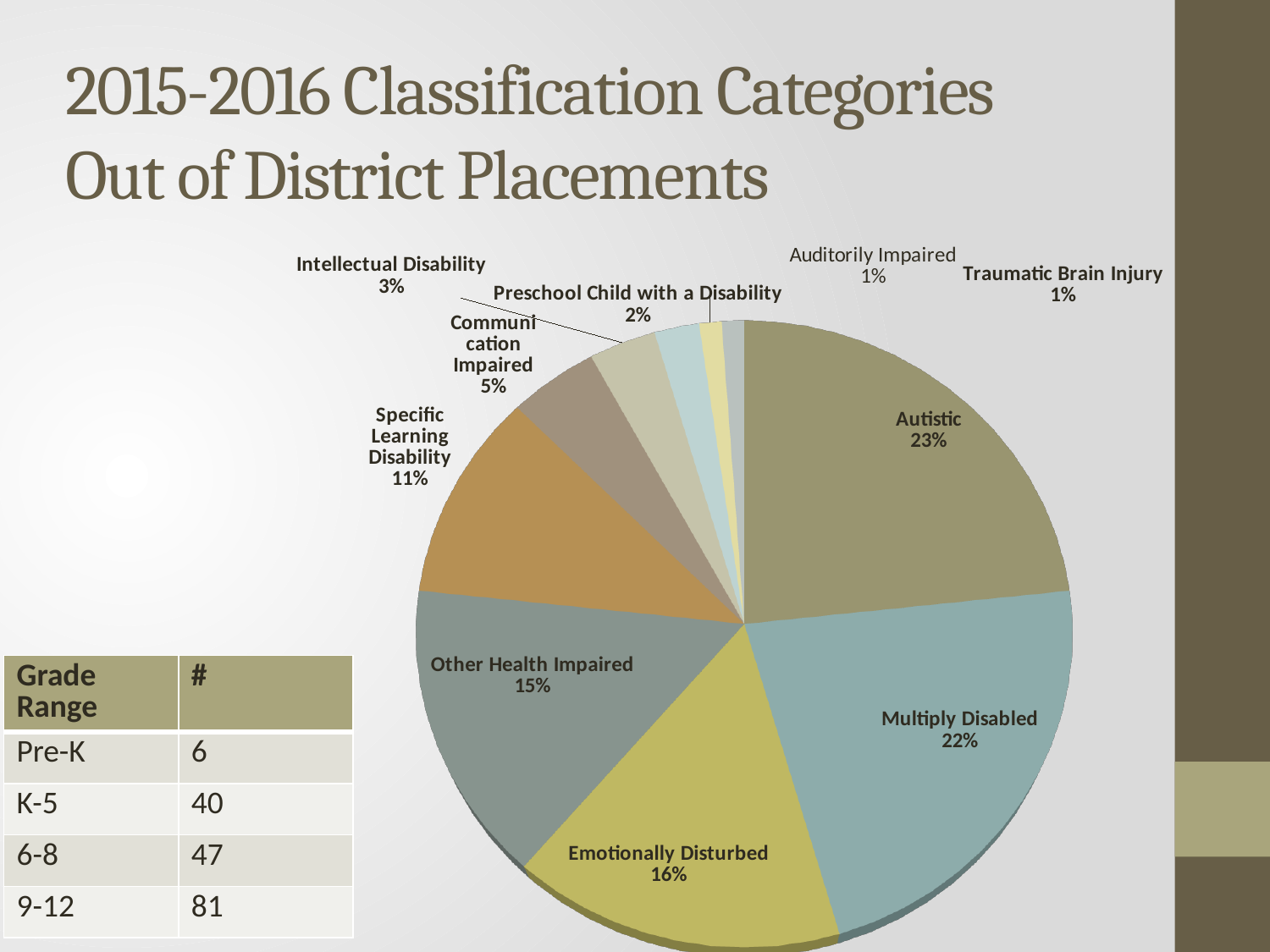
What type of chart is shown on the slide? pie chart Which is larger, the share for Emotionally Disturbed or the share for Other Health Impaired? Emotionally Disturbed What percentage of out of district placements is classified as Communication Impaired? 5% How many classification categories are shown in the pie chart? 10 What percentage of out of district placements is classified as Autistic? 23% Which classification category has the largest share of the pie? Autistic What percentage of out of district placements is classified as Multiply Disabled? 22% What percentage of out of district placements is classified as Emotionally Disturbed? 16% What is the combined percentage of Auditorily Impaired and Traumatic Brain Injury? 2% What is the title of the slide containing the pie chart? 2015-2016 Classification Categories Out of District Placements What percentage of out of district placements is classified as Specific Learning Disability? 11% What is the difference in percentage points between Other Health Impaired and Intellectual Disability? 12